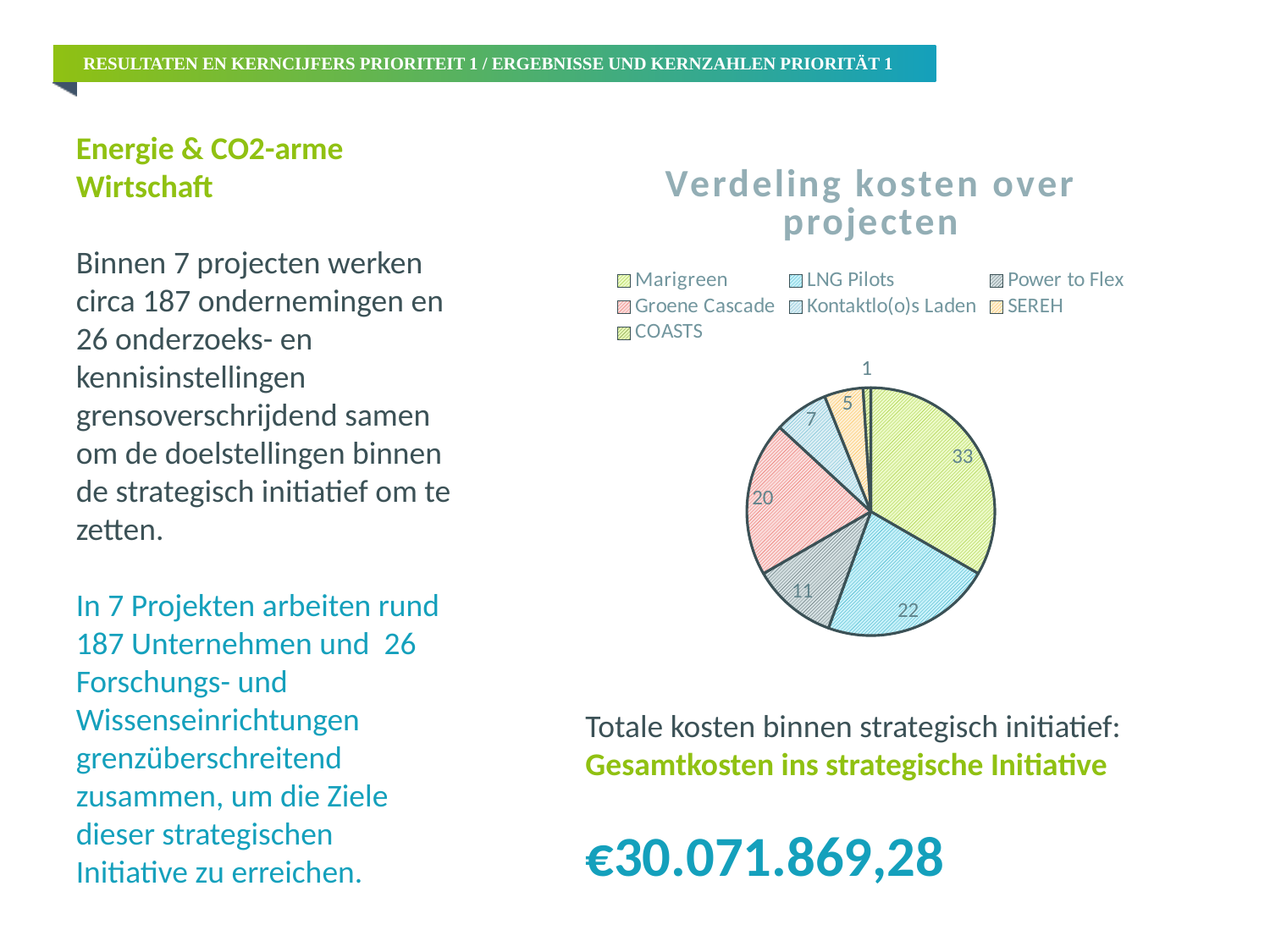
Which project has the smallest slice in the pie chart? COASTS Which project has the largest slice in the pie chart? Marigreen What is the value shown for Marigreen in the pie chart? 33 What is the title of the pie chart? Verdeling kosten over projecten What is the value shown for Groene Cascade in the pie chart? 20 How many projects are listed in the legend of the pie chart? 7 What is the value shown for Power to Flex in the pie chart? 11 What is the value shown for LNG Pilots in the pie chart? 22 What is the difference between the values for Marigreen and LNG Pilots in the pie chart? 11 What kind of chart is shown under the title "Verdeling kosten over projecten"? pie chart What is the value shown for SEREH in the pie chart? 5 Which is larger in the pie chart, Groene Cascade or Power to Flex? Groene Cascade